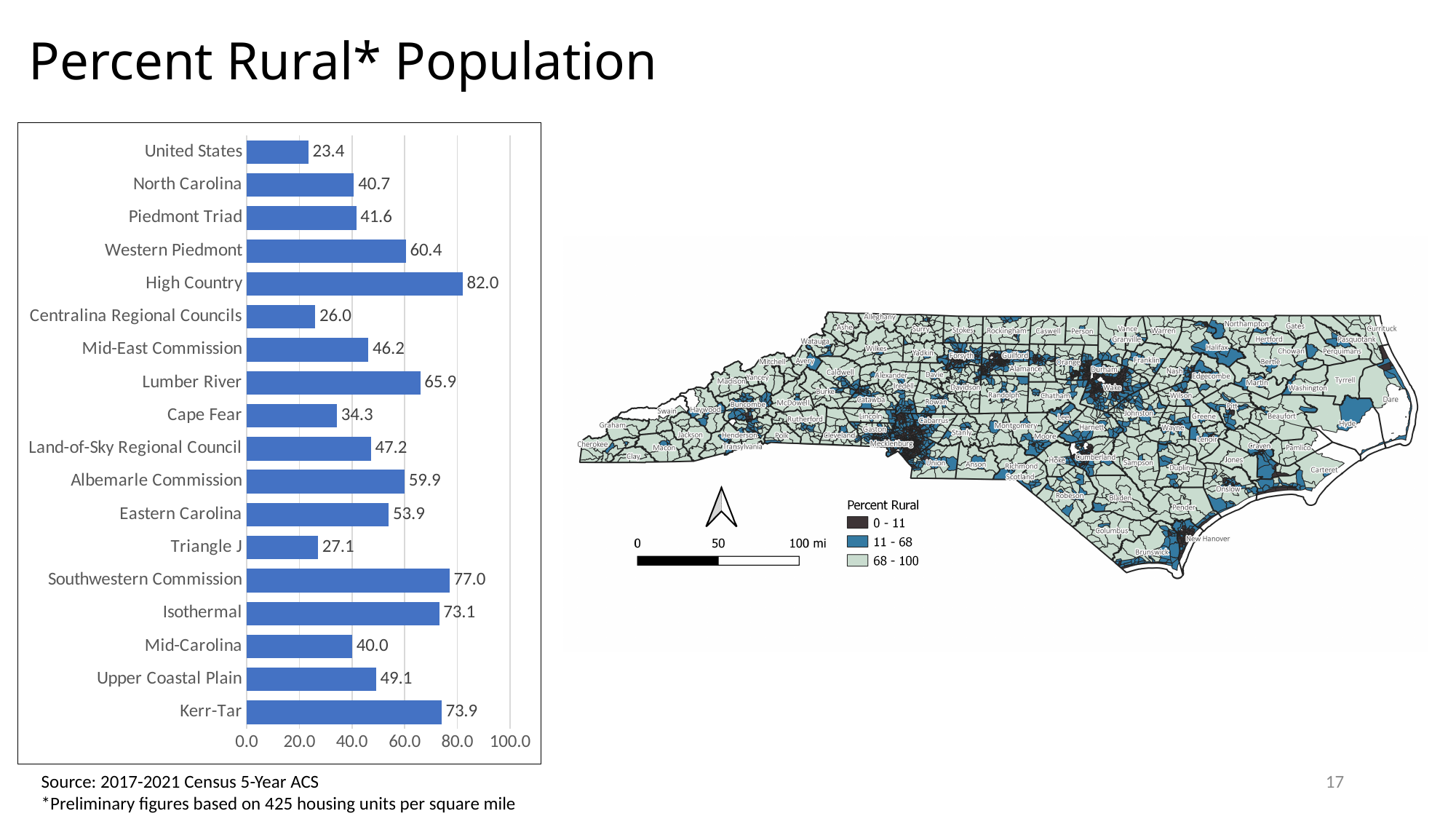
What kind of chart is used to show the percent rural population by region? Bar chart Is the value for Cape Fear greater or less than 40.0? less What is the difference between the percent rural population of Southwestern Commission and Isothermal? 3.9 What is the percent rural population for Kerr-Tar? 73.9 Which category has the lowest percent rural population in the bar chart? United States What is the percent rural population for High Country? 82.0 Which category has the highest percent rural population in the bar chart? High Country Which has a higher percent rural population, Lumber River or Western Piedmont? Lumber River What is the percent rural population for North Carolina? 40.7 How many ranges does the map legend for Percent Rural list? 3 What is the difference between the percent rural population of High Country and the United States? 58.6 How many categories are shown in the bar chart? 18